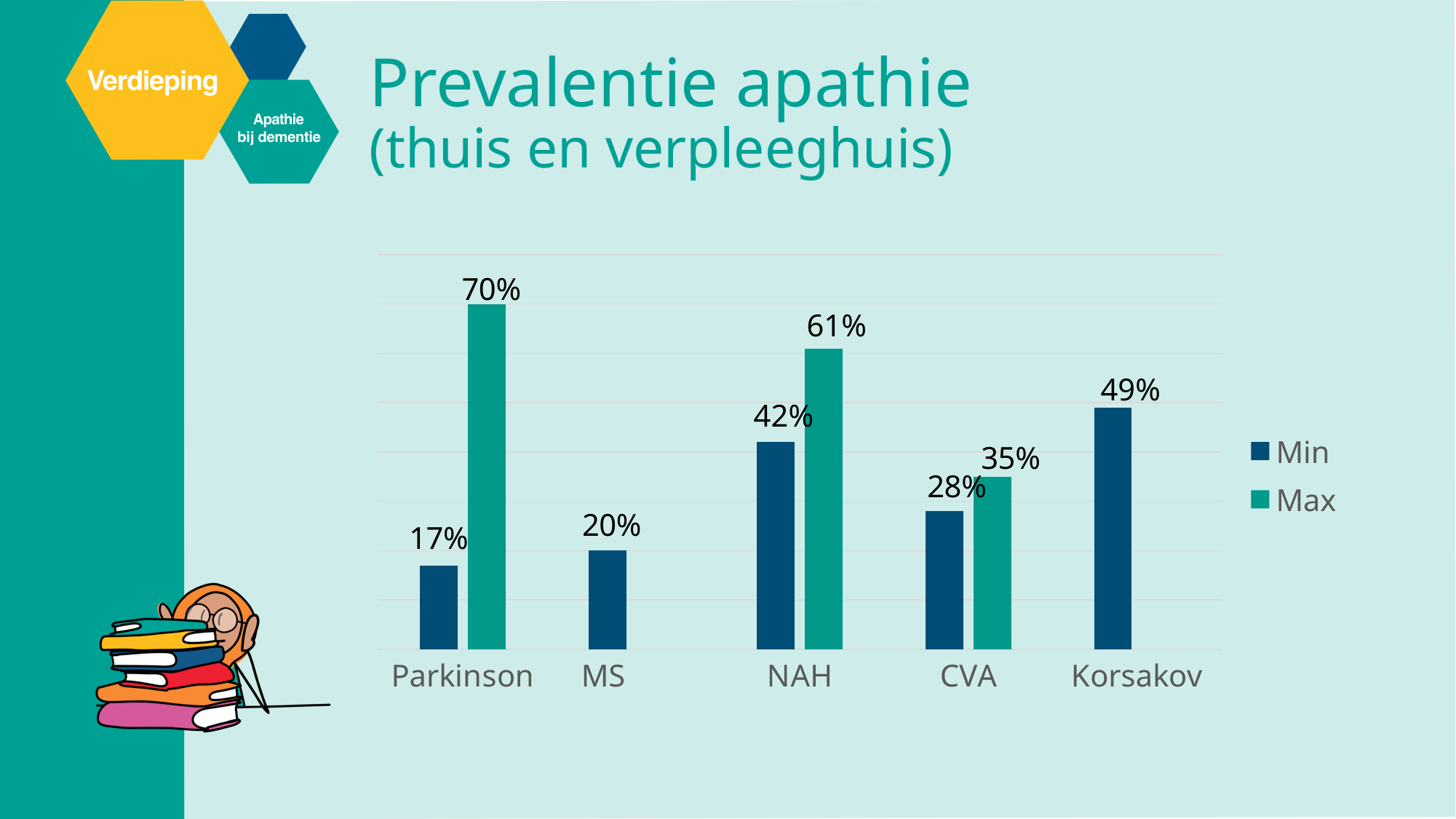
What kind of chart is shown on the slide? Bar chart How many categories are shown on the x axis? 5 What is the Max value for NAH? 61% What is the Min value for Korsakov? 49% Which is larger, the Min value for Korsakov or the Max value for CVA? Min value for Korsakov What is the difference between the Max and Min values for Parkinson? 53% What is the Max value for CVA? 35% What is the difference between the Min values for NAH and CVA? 14% Which category has the highest Max value? Parkinson What is the Min value for Parkinson? 17% How many series does the legend list? 2 Which category has the lowest Min value? Parkinson